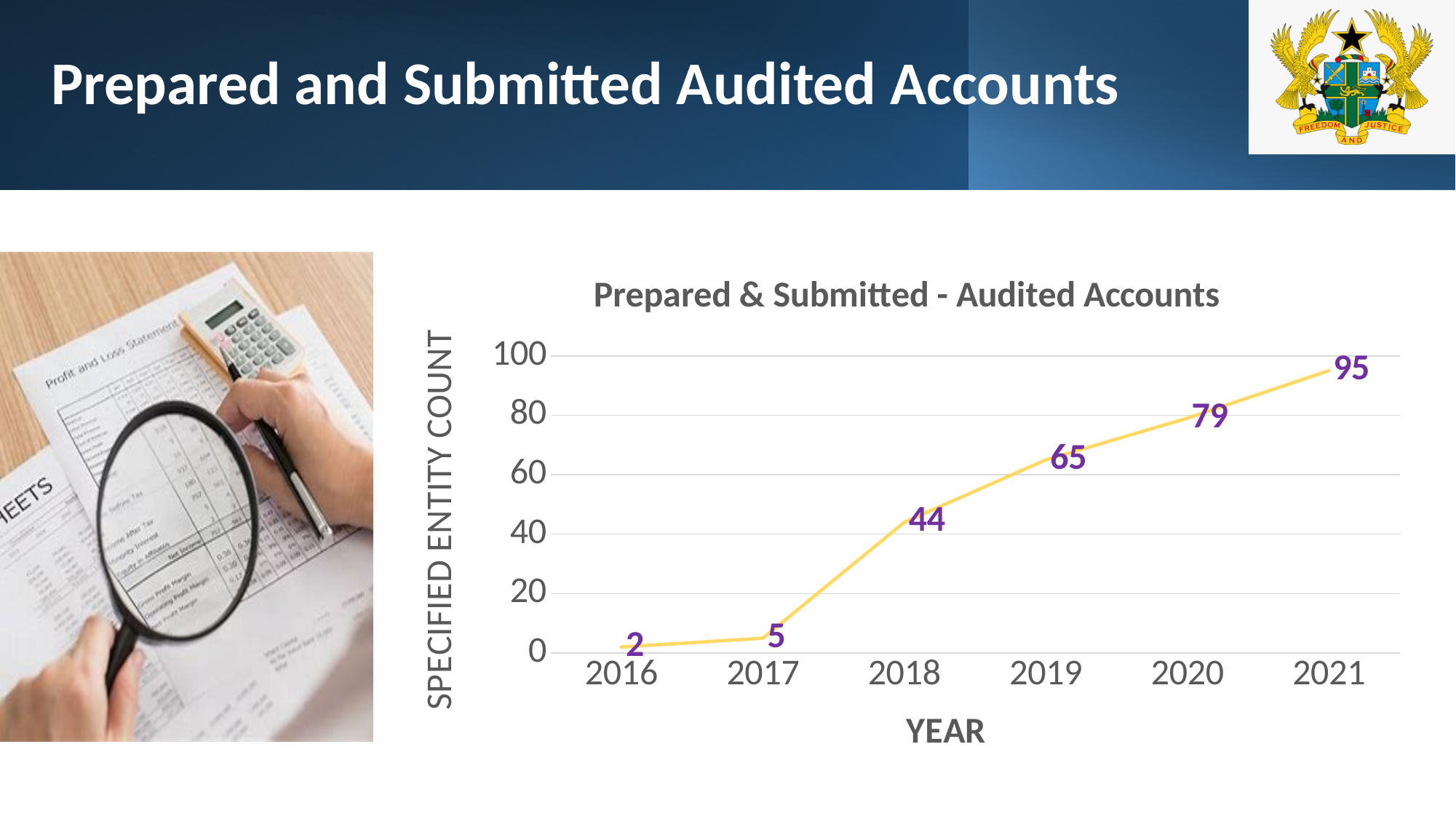
How many years are plotted on the x axis? 6 Do the values rise or fall from 2016 to 2021? rise What is the value for 2016? 2 Which is larger, the value for 2017 or the value for 2018? 2018 Is the value for 2019 greater or less than 60? greater Which year has the lowest value? 2016 What is the difference between the values for 2020 and 2019? 14 What is the value for 2021? 95 What is the title of the chart? Prepared & Submitted - Audited Accounts What kind of chart is shown? line chart Which year has the highest value? 2021 What is the value for 2018? 44